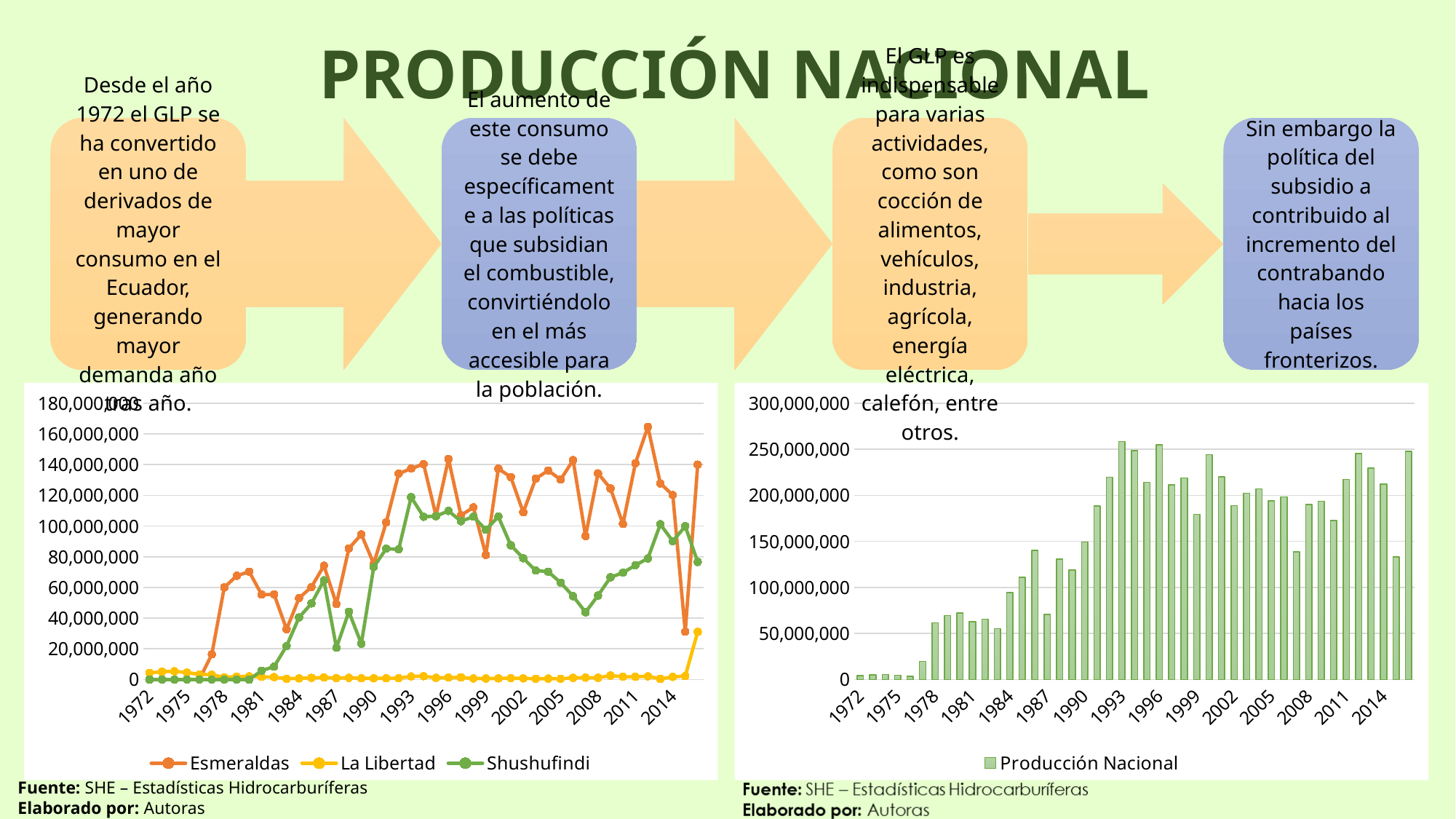
What kind of chart is the chart on the left side of the slide? line chart In the Producción Nacional chart, is the value for 1993 greater or less than 250,000,000? greater In the left chart, which series has the lowest values across most of the years shown? La Libertad Which series are listed in the legend of the left chart? Esmeraldas, La Libertad, Shushufindi In the Producción Nacional chart, is the value for 1972 greater or less than 50,000,000? less How many series does the legend of the left chart list? 3 In the left chart, is the highest value for Esmeraldas greater or less than 160,000,000? greater In the Producción Nacional chart, do the values generally rise or fall from 1972 to 1993? rise What kind of chart is the Producción Nacional chart on the right side of the slide? bar chart In the left chart, which series is higher in 2008, Esmeraldas or Shushufindi? Esmeraldas